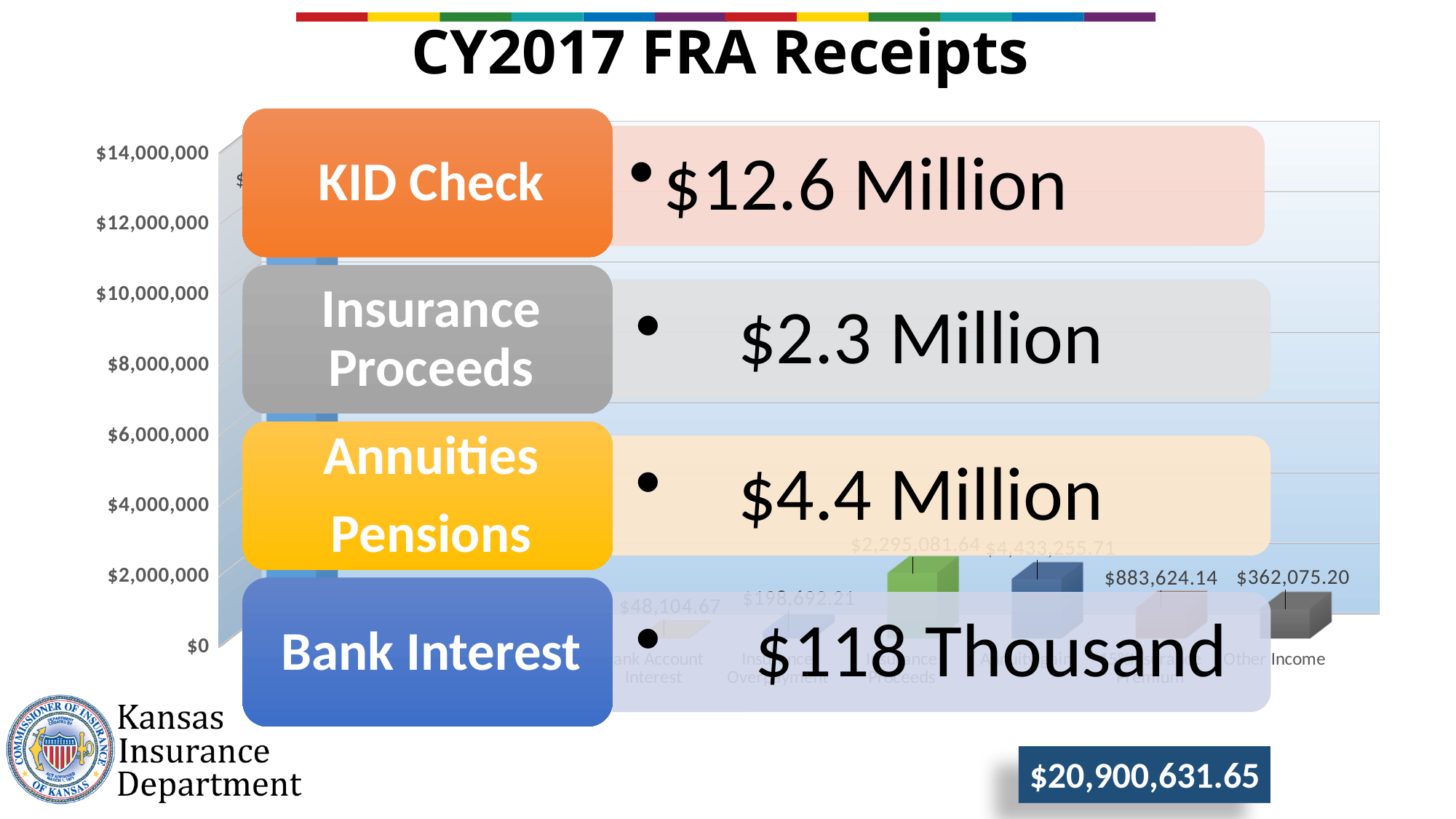
Is the value for Other Income greater or less than $2,000,000? less What is the highest value shown on the vertical axis of the chart? $14,000,000 What is the title of the chart on the slide? CY2017 FRA Receipts What is the value shown for Other Income? $362,075.20 What is the value shown for Insurance Proceeds? $2,295,081.64 Which is larger, the value for Insurance Proceeds or the value for Other Income? Insurance Proceeds What is the difference between the value for Insurance Proceeds and the value for Other Income? $1,933,006.44 Is the value for Insurance Proceeds greater or less than $2,000,000? greater What kind of chart is shown on the slide? bar chart